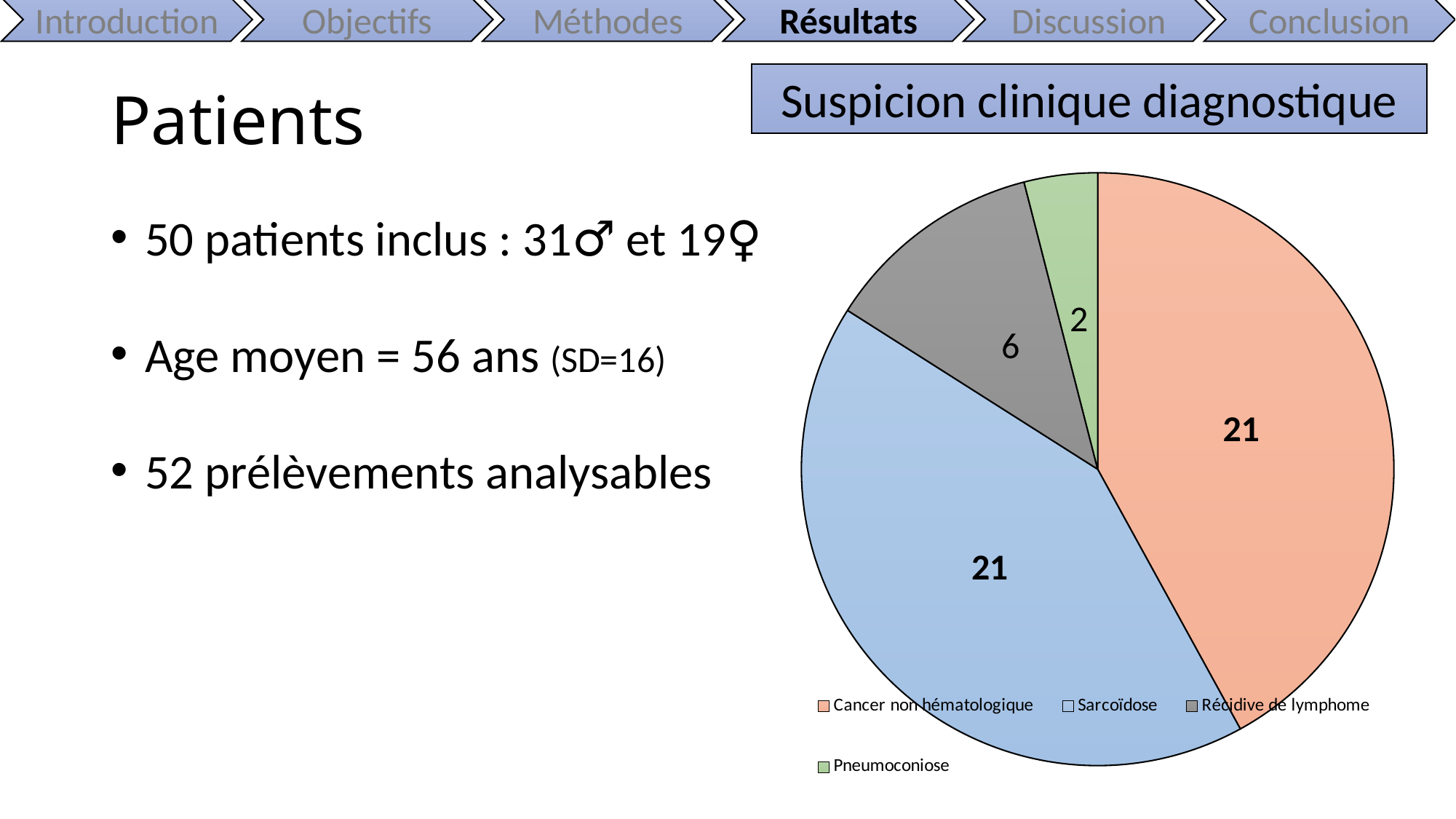
What is the difference between the values for Récidive de lymphome and Pneumoconiose? 4 How many slices does the pie chart have? 4 What is the value for Récidive de lymphome? 6 What is the total of all the values shown in the pie chart? 50 What is the value for Pneumoconiose? 2 What type of chart is shown on the slide? pie chart What is the value for Cancer non hématologique? 21 How many entries does the chart legend list? 4 Which is larger, the value for Récidive de lymphome or the value for Pneumoconiose? Récidive de lymphome What is the title of the chart? Suspicion clinique diagnostique What share of the pie does Récidive de lymphome represent? 12% Which category has the smallest slice of the pie? Pneumoconiose